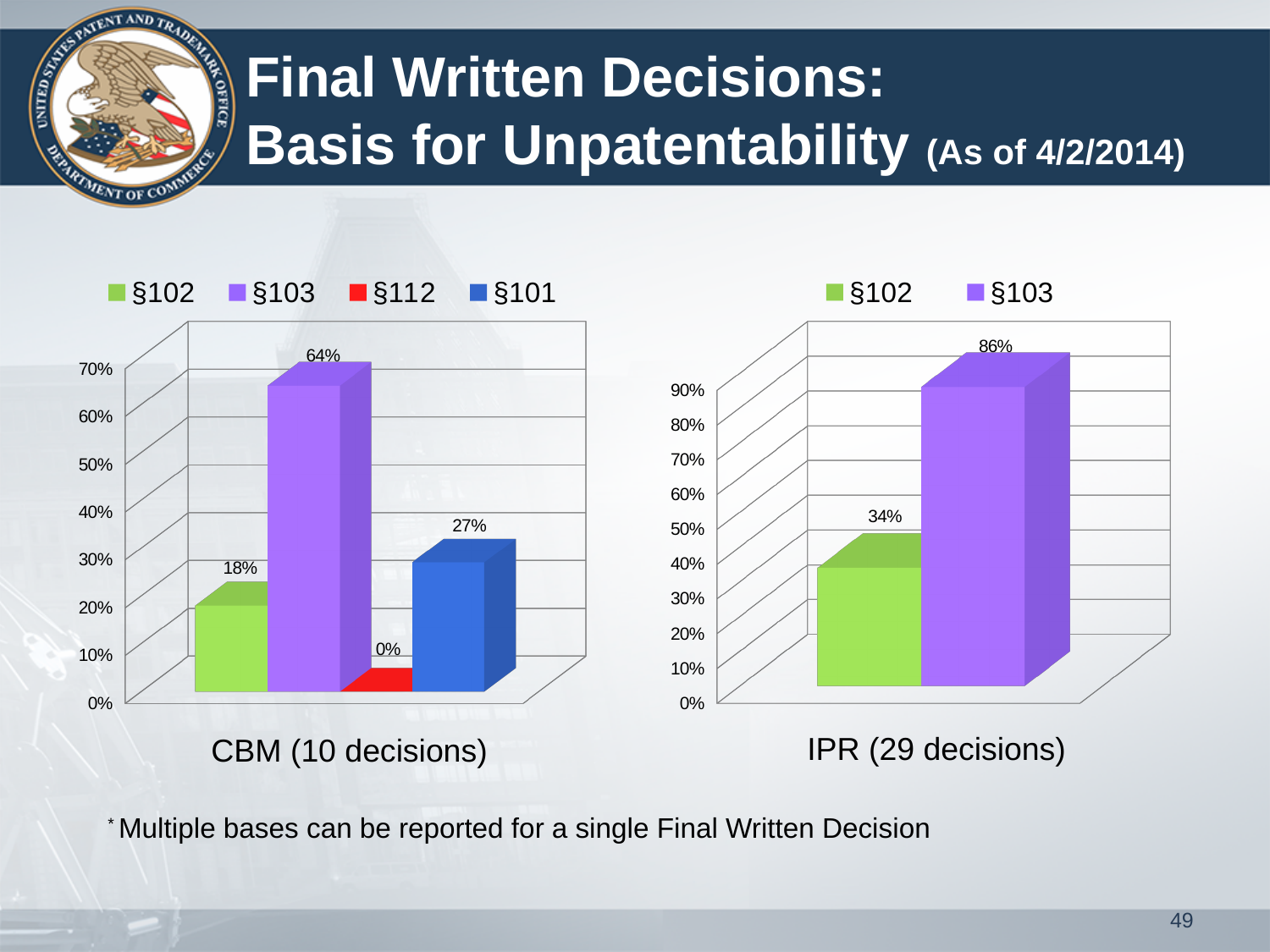
How many series does the legend of the CBM (10 decisions) chart list? 4 In the IPR (29 decisions) chart, what is the difference between the §103 and §102 values? 52% How many series does the legend of the IPR (29 decisions) chart list? 2 In the IPR (29 decisions) chart, what is the value for §102? 34% In the CBM (10 decisions) chart, what is the value for §103? 64% In the CBM (10 decisions) chart, which is larger, the value for §102 or the value for §101? §101 What kind of chart is the IPR (29 decisions) chart? Bar chart In the IPR (29 decisions) chart, what is the value for §103? 86% In the CBM (10 decisions) chart, what is the value for §101? 27% In the CBM (10 decisions) chart, what is the difference between the §103 and §101 values? 37% In the CBM (10 decisions) chart, which basis has the lowest value? §112 In the CBM (10 decisions) chart, which basis has the highest value? §103